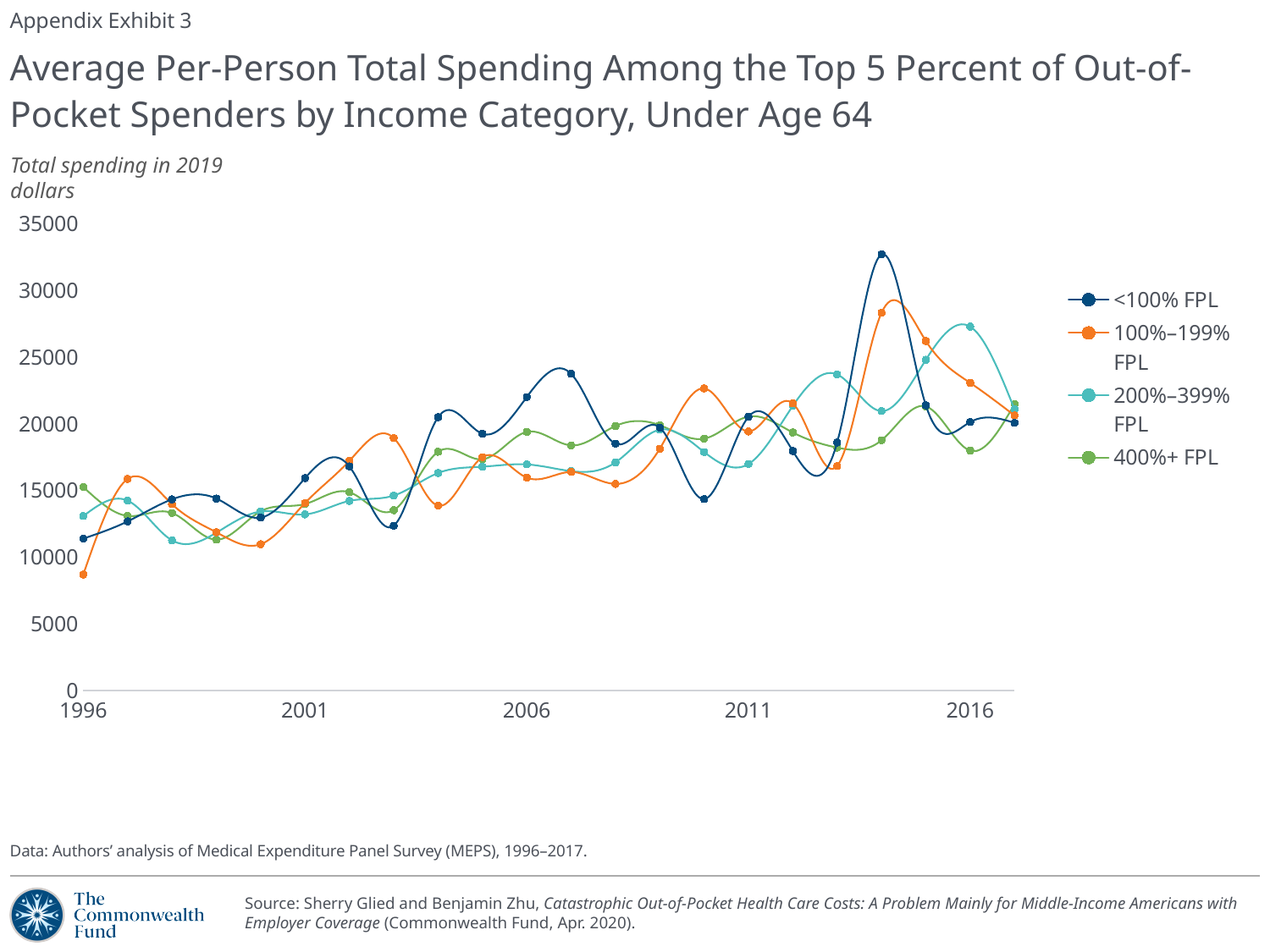
Is the value for 100%–199% FPL in 1996 greater or less than 10000? less In 2014, which is larger: the value for <100% FPL or the value for 400%+ FPL? <100% FPL What kind of chart is shown on the slide? Line chart Which series reaches the highest value anywhere on the chart? <100% FPL How many yearly data points does each series have? 22 Is the value for <100% FPL in 2014 greater or less than 30000? greater In 1996, which is larger: the value for 400%+ FPL or the value for 100%–199% FPL? 400%+ FPL How many series does the legend list? 4 Is the value for 200%–399% FPL in 2016 greater or less than 25000? greater What colour is the line for 100%–199% FPL? Orange Overall, does the 400%+ FPL series rise or fall from 1996 to 2017? rise